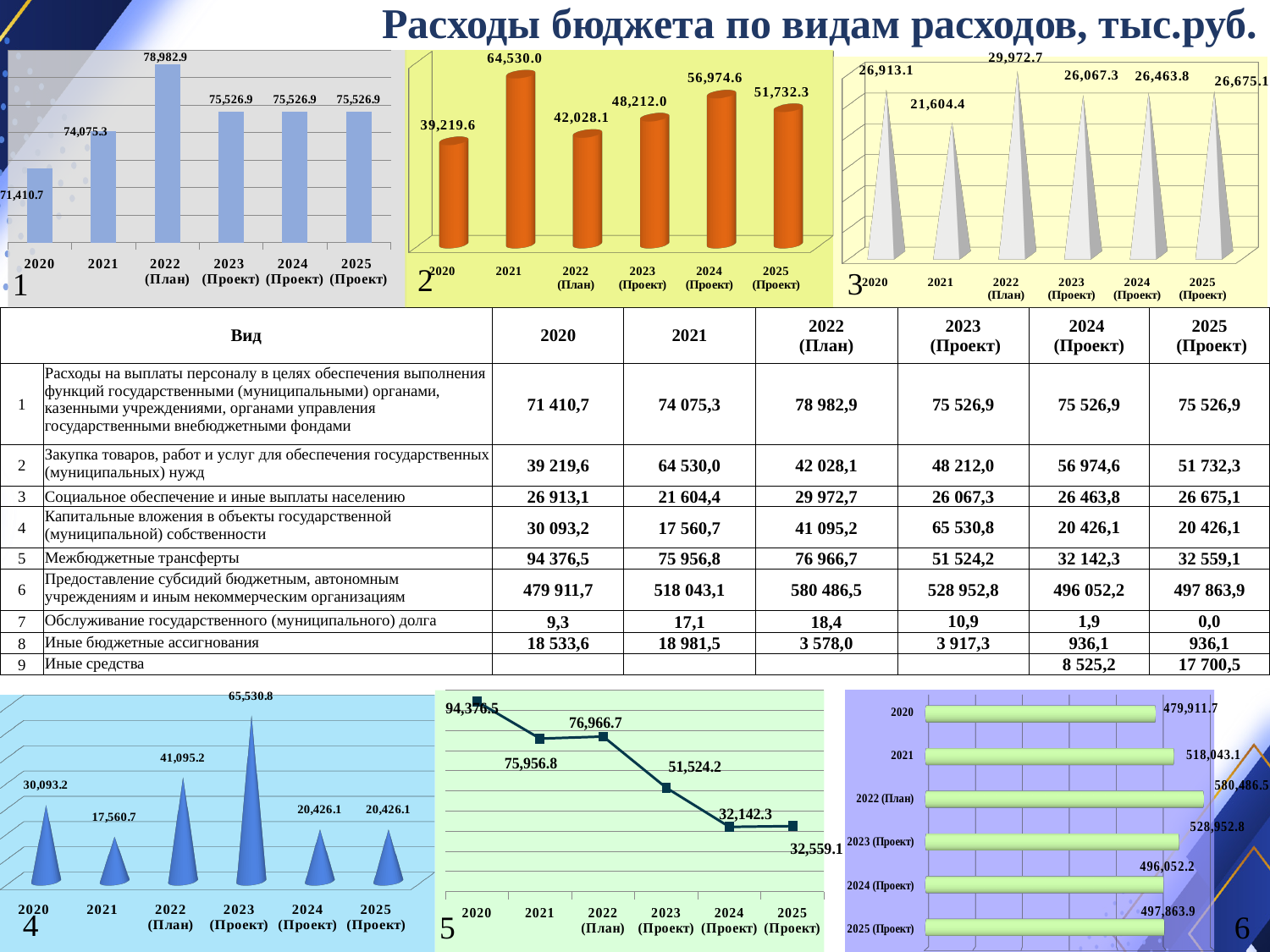
In chart 1 (top-left bar chart), what is the value for 2022 (План)? 78,982.9 In chart 6 (bottom-right horizontal bar chart), what is the value for 2022 (План)? 580,486.5 What kind of chart is chart 5 (bottom-middle)? line chart In chart 2 (top-middle orange bar chart), which year has the highest value? 2021 In chart 4 (bottom-left cone chart), which is larger, the value for 2020 or the value for 2021? 2020 In chart 4 (bottom-left cone chart), what is the value for 2023 (Проект)? 65,530.8 In chart 1 (top-left bar chart), which year has the lowest value? 2020 In chart 2 (top-middle orange bar chart), what is the value for 2024 (Проект)? 56,974.6 In chart 3 (top-right cone chart), what is the value for 2021? 21,604.4 In chart 2 (top-middle orange bar chart), what is the difference between the 2021 value and the 2020 value? 25,310.4 In chart 5 (bottom-middle line chart), do the values generally rise or fall from 2020 to 2025 (Проект)? fall In chart 3 (top-right cone chart), which year has the highest value? 2022 (План)